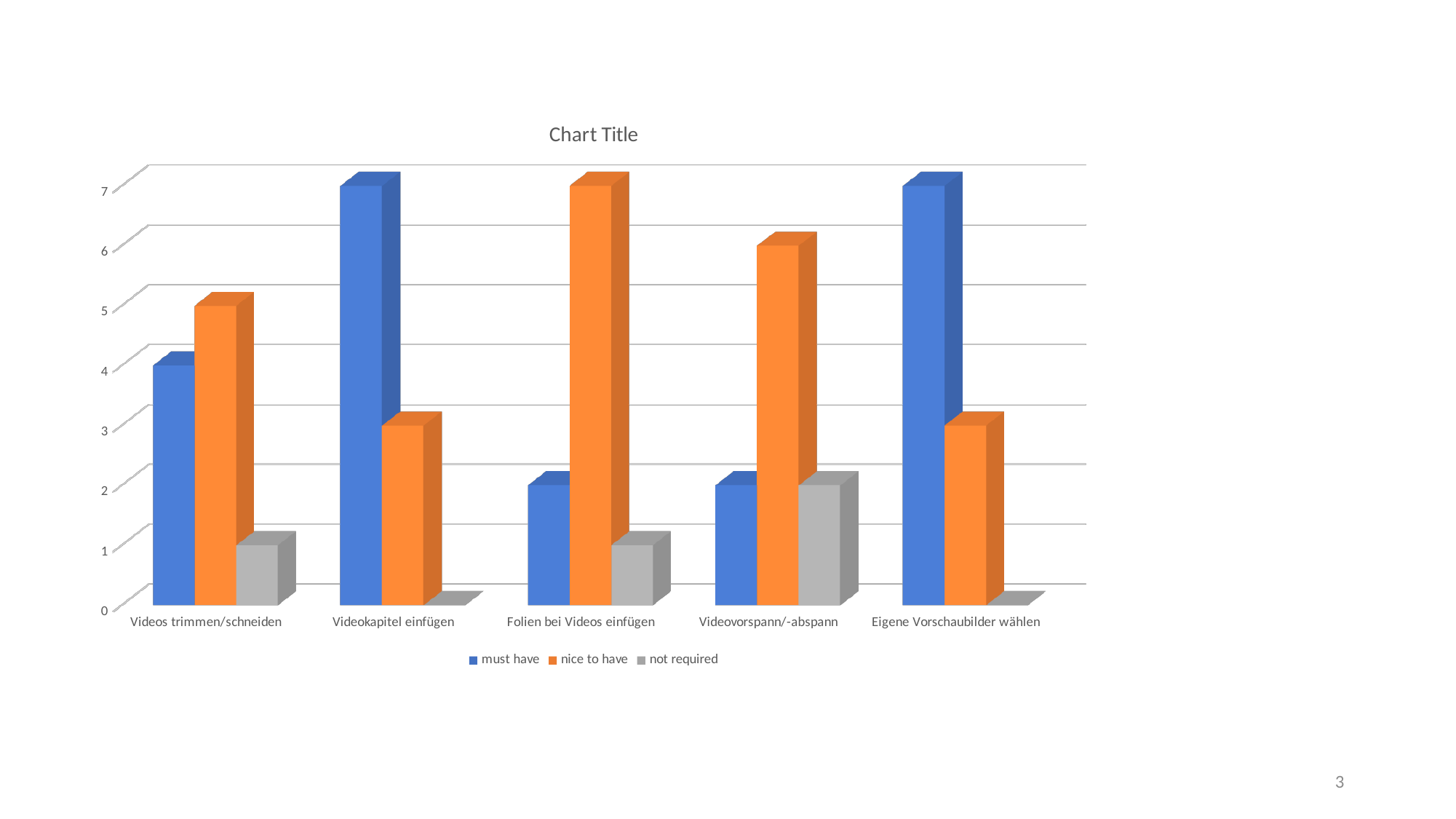
For Folien bei Videos einfügen, which is larger: 'must have' or 'nice to have'? nice to have Which category has the highest 'nice to have' value? Folien bei Videos einfügen What kind of chart is shown on the slide? bar chart How many series does the legend list? 3 Is the 'must have' value for Videos trimmen/schneiden greater or less than 3? greater What is the value of 'must have' for Videokapitel einfügen? 7 How many categories are shown on the x axis? 5 Is the 'nice to have' value for Videovorspann/-abspann greater or less than 5? greater What is the value of 'not required' for Videos trimmen/schneiden? 1 What is the value of 'nice to have' for Videos trimmen/schneiden? 5 Which category has the highest 'not required' value? Videovorspann/-abspann What is the title of the chart? Chart Title